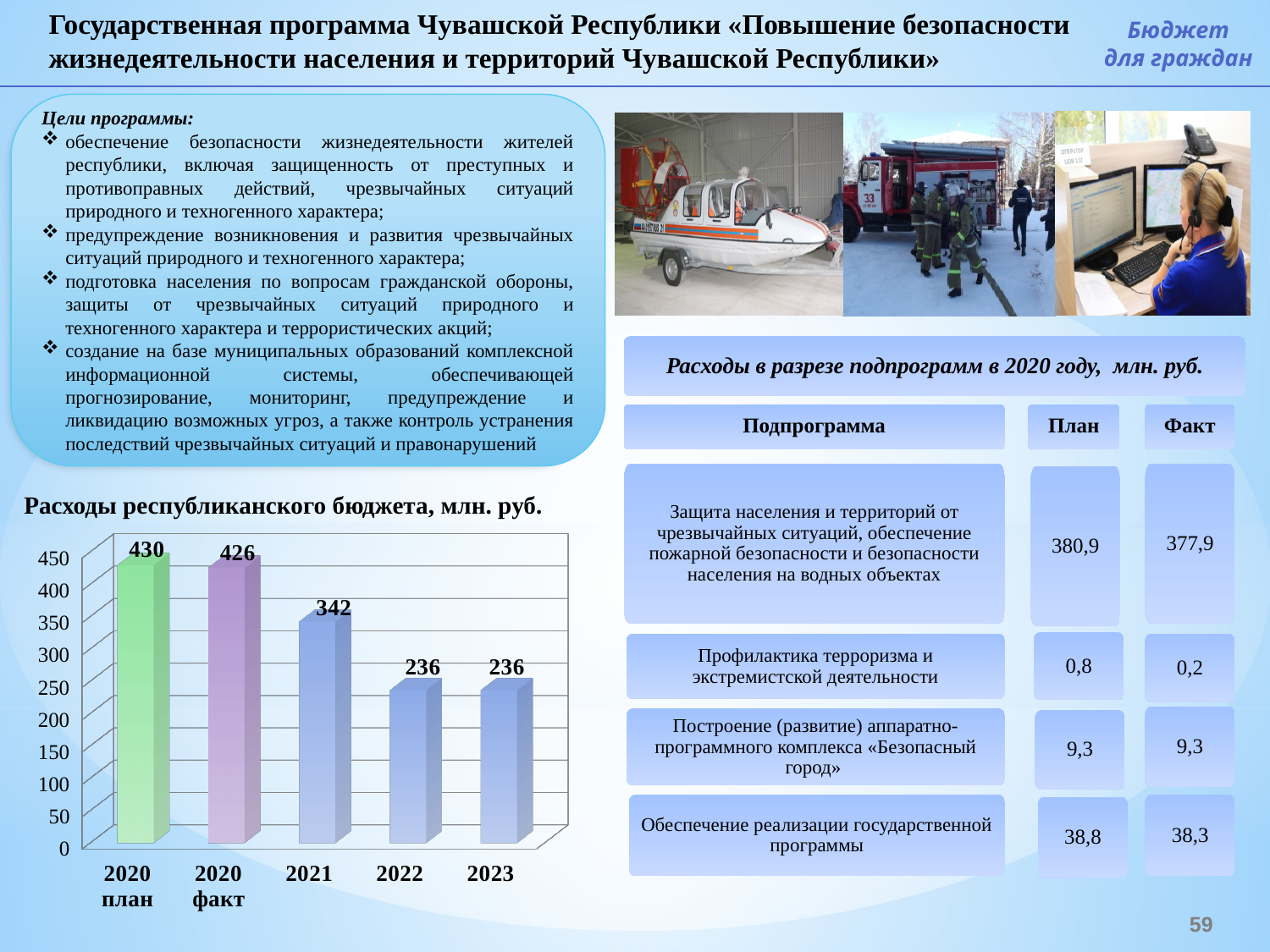
What is the value for 2020 факт in the chart? 426 What is the title of the chart on the slide? Расходы республиканского бюджета, млн. руб. Which is larger, the value for 2021 or the value for 2022? 2021 What kind of chart is shown on the slide? bar chart Is the value for 2021 greater or less than 300? greater What is the difference between the values for 2021 and 2022? 106 What is the value for 2023 in the chart? 236 What is the difference between the values for 2020 план and 2020 факт? 4 What is the value for 2020 план in the chart 'Расходы республиканского бюджета, млн. руб.'? 430 How many bars are shown in the chart? 5 What is the value for 2021 in the chart? 342 Which category has the highest value in the chart? 2020 план